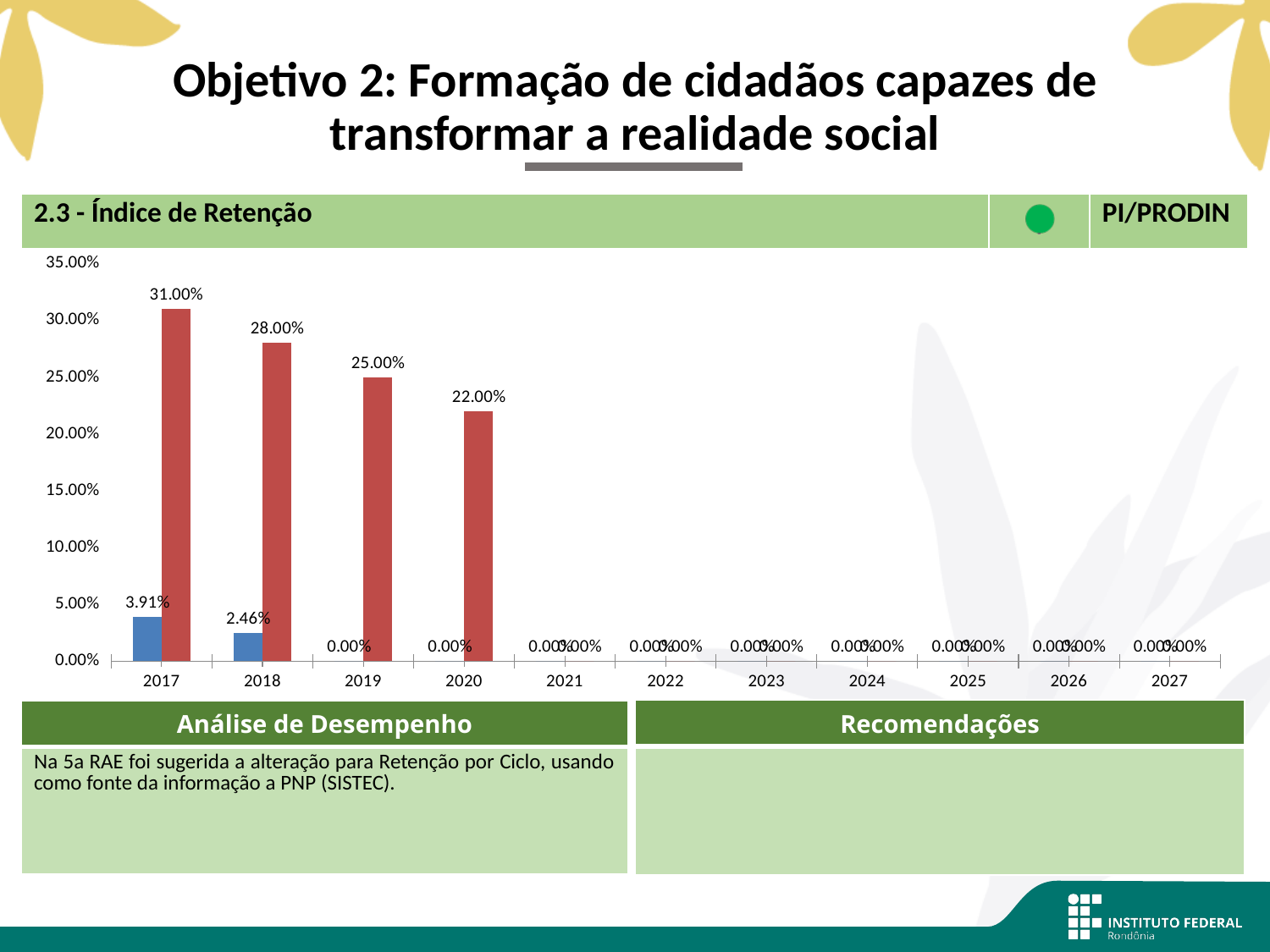
Which is larger, the red bar for 2018 or the red bar for 2019? 2018 Do the red bar values rise or fall from 2017 to 2020? fall Is the red bar value for 2019 greater or less than 20.00%? greater What is the value of the blue bar for 2017? 3.91% What is the difference between the red bar values for 2017 and 2020? 9.00% What is the difference between the blue bar values for 2017 and 2018? 1.45% What is the value of the red bar for 2020? 22.00% What kind of chart is shown on the slide? bar chart What is the value of the blue bar for 2018? 2.46% How many years are shown on the x axis? 11 What is the value of the red bar for 2017? 31.00% Which year has the highest red bar? 2017